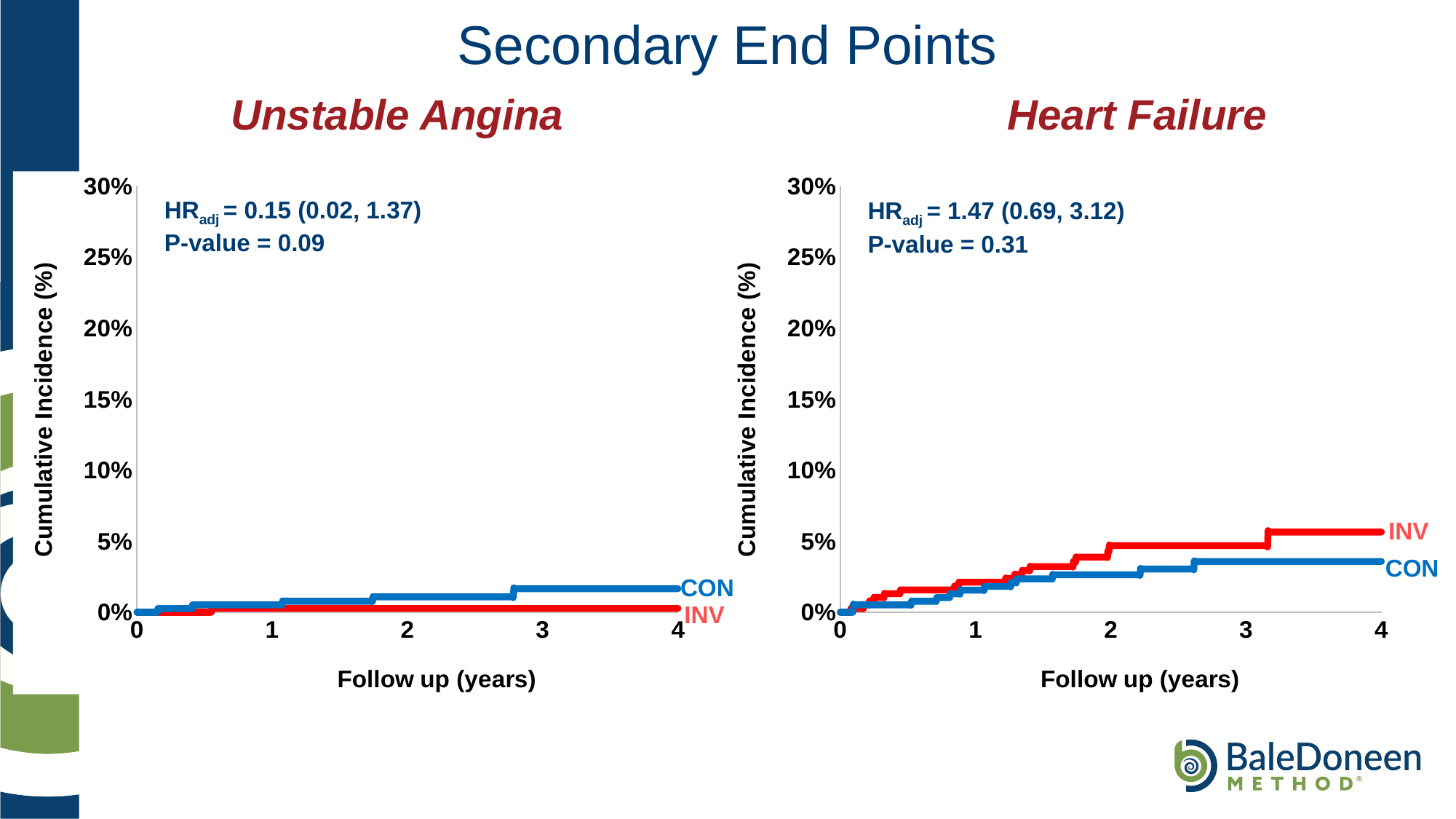
In the Heart Failure chart, which series has the higher cumulative incidence at 4 years of follow up, CON or INV? INV What kind of chart is the Unstable Angina chart? line chart In the Unstable Angina chart, which series has the higher cumulative incidence at 4 years of follow up, CON or INV? CON In the Unstable Angina chart, is the cumulative incidence for CON at 4 years greater or less than 5%? less In the Heart Failure chart, does the cumulative incidence for INV rise or fall as follow up years increase? rise In the Heart Failure chart, is the cumulative incidence for CON at 4 years greater or less than 5%? less In the Heart Failure chart, is the cumulative incidence for INV at 4 years greater or less than 5%? greater What is the maximum value shown on the y axis of the Unstable Angina chart? 30% How many series are plotted in the Heart Failure chart? 2 What adjusted hazard ratio is printed on the Heart Failure chart? 1.47 (0.69, 3.12)